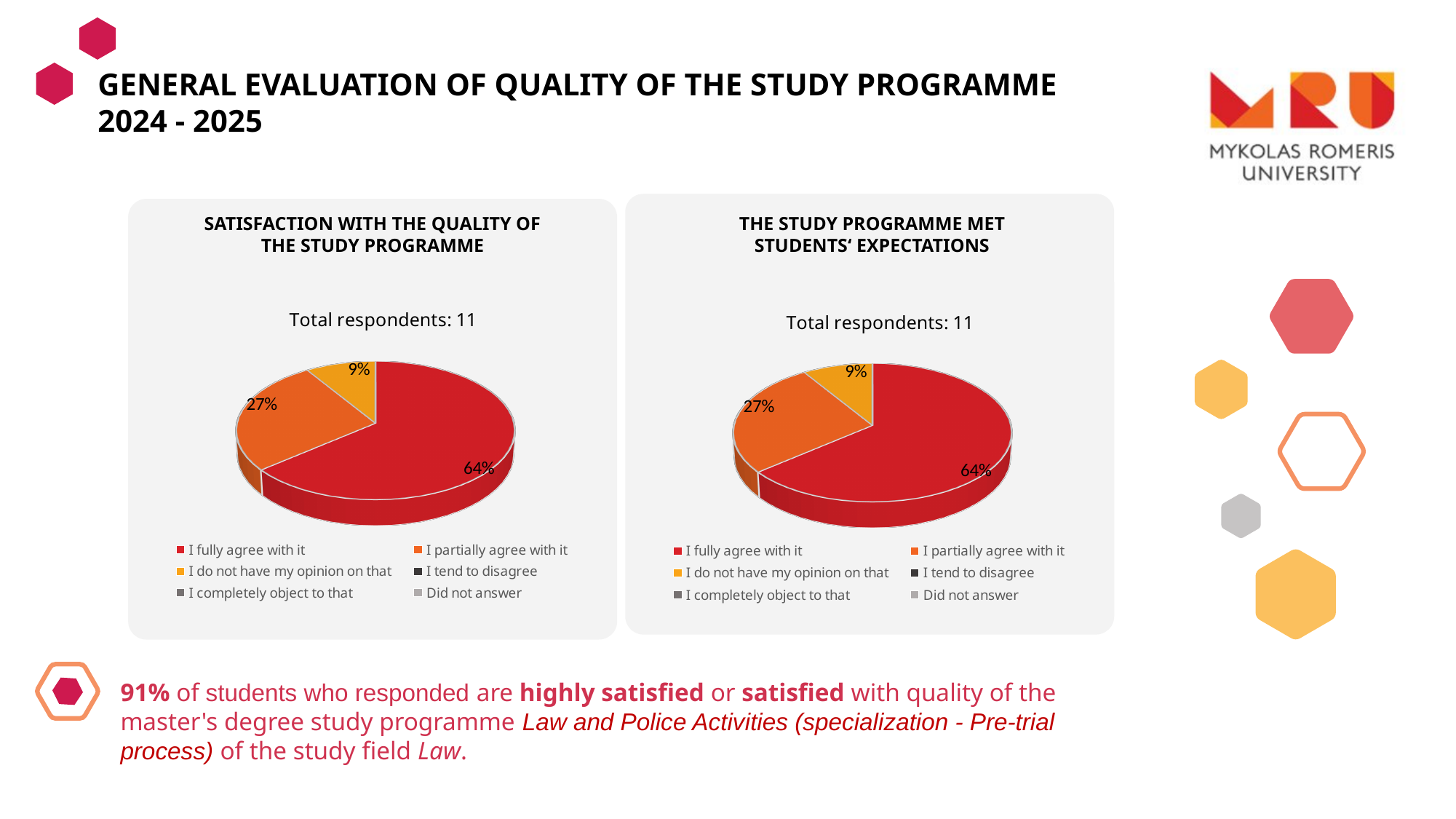
In the chart titled "Satisfaction with the quality of the study programme", which response has the largest slice? I fully agree with it In the chart titled "Satisfaction with the quality of the study programme", what is the difference in percentage points between "I fully agree with it" and "I partially agree with it"? 37 percentage points In the chart titled "The study programme met students' expectations", what share of respondents chose "I fully agree with it"? 64% In the chart titled "The study programme met students' expectations", which labelled response has the smallest slice? I do not have my opinion on that In the chart titled "The study programme met students' expectations", which is larger: "I partially agree with it" or "I do not have my opinion on that"? I partially agree with it In the chart titled "Satisfaction with the quality of the study programme", what share of respondents chose "I do not have my opinion on that"? 9% In the chart titled "Satisfaction with the quality of the study programme", what share of respondents chose "I fully agree with it"? 64% In the chart titled "Satisfaction with the quality of the study programme", what share of respondents chose "I partially agree with it"? 27% In the chart titled "The study programme met students' expectations", what share of respondents chose "I do not have my opinion on that"? 9% What type of chart is used in the chart titled "Satisfaction with the quality of the study programme"? Pie chart How many total respondents are reported for the chart titled "Satisfaction with the quality of the study programme"? 11 How many entries does the legend list in the chart titled "The study programme met students' expectations"? 6